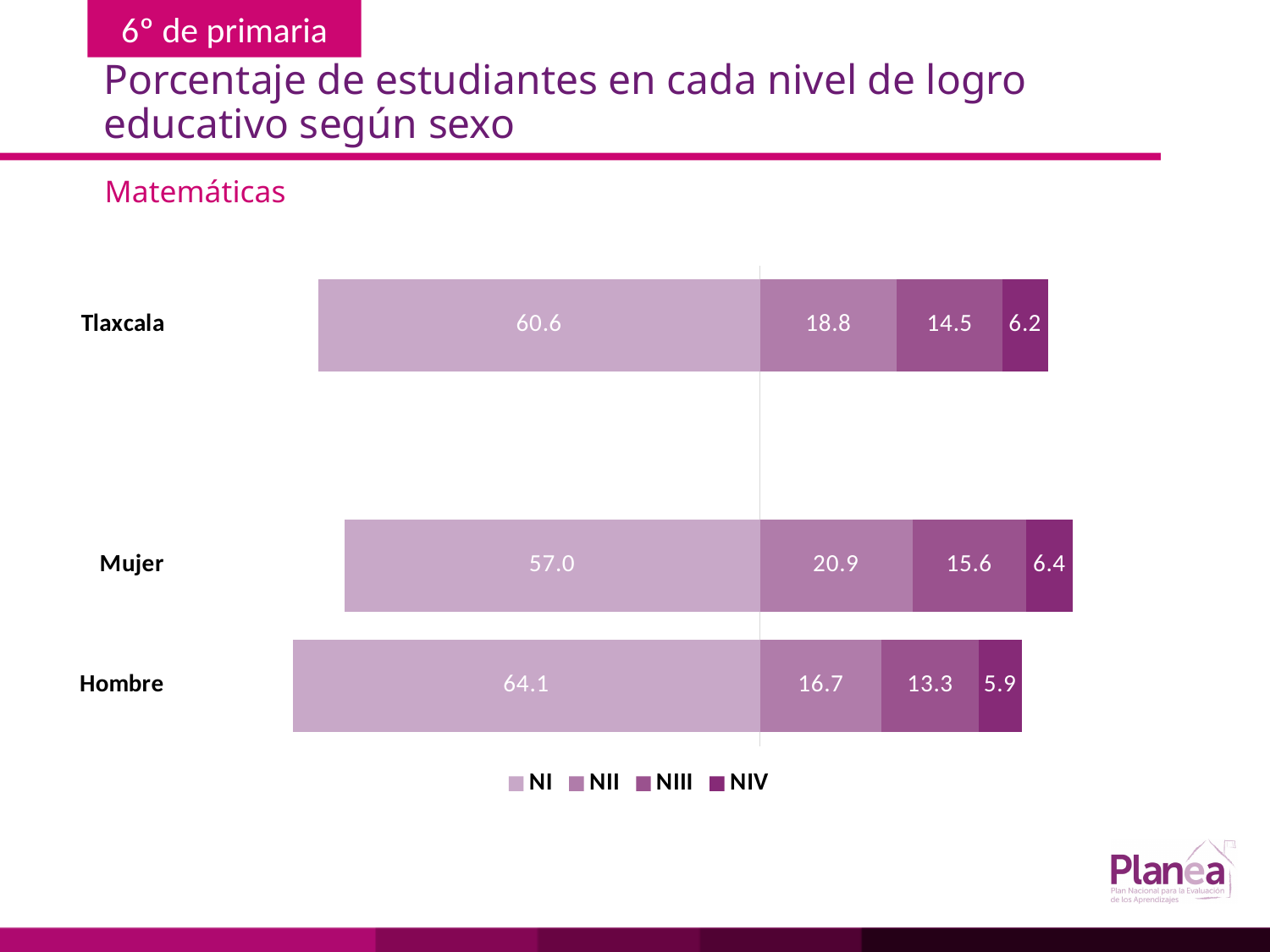
How many categories are shown on the chart? 3 What is the difference between the NI values for Hombre and Mujer? 7.1 Which category has the lowest NIV value? Hombre Which is larger, the NII value for Tlaxcala or the NII value for Hombre? Tlaxcala What is the NIV value for Tlaxcala? 6.2 What is the total of the stacked bar for Hombre? 100.0 Which category has the highest NI value? Hombre What is the NI value for Hombre? 64.1 How many series does the legend list? 4 What is the NIII value for Hombre? 13.3 What is the NII value for Mujer? 20.9 What kind of chart is shown on the slide? Stacked bar chart